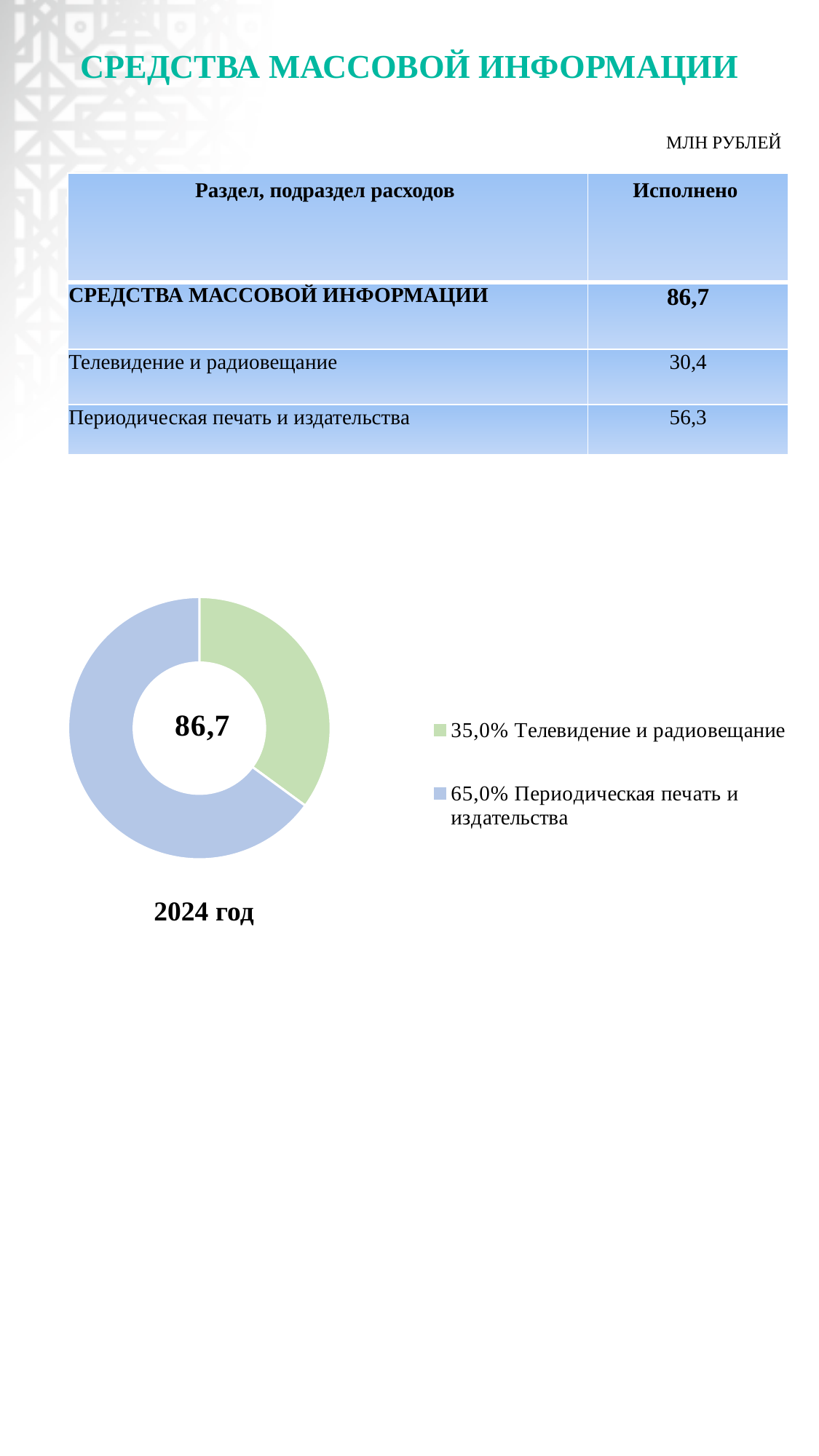
What share of the doughnut chart does Периодическая печать и издательства have? 65,0% By how many percentage points does the share of Периодическая печать и издательства exceed that of Телевидение и радиовещание? 30,0 What colour is the slice for Телевидение и радиовещание in the doughnut chart? green Which category has the largest slice in the doughnut chart? Периодическая печать и издательства What share of the doughnut chart does Телевидение и радиовещание have? 35,0% How many entries does the legend of the doughnut chart list? 2 What year label is shown below the doughnut chart? 2024 год What total value is shown in the centre of the doughnut chart? 86,7 How many slices does the doughnut chart have? 2 What kind of chart is shown on the slide? doughnut chart Which slice is larger: Телевидение и радиовещание or Периодическая печать и издательства? Периодическая печать и издательства Which category has the smallest slice in the doughnut chart? Телевидение и радиовещание